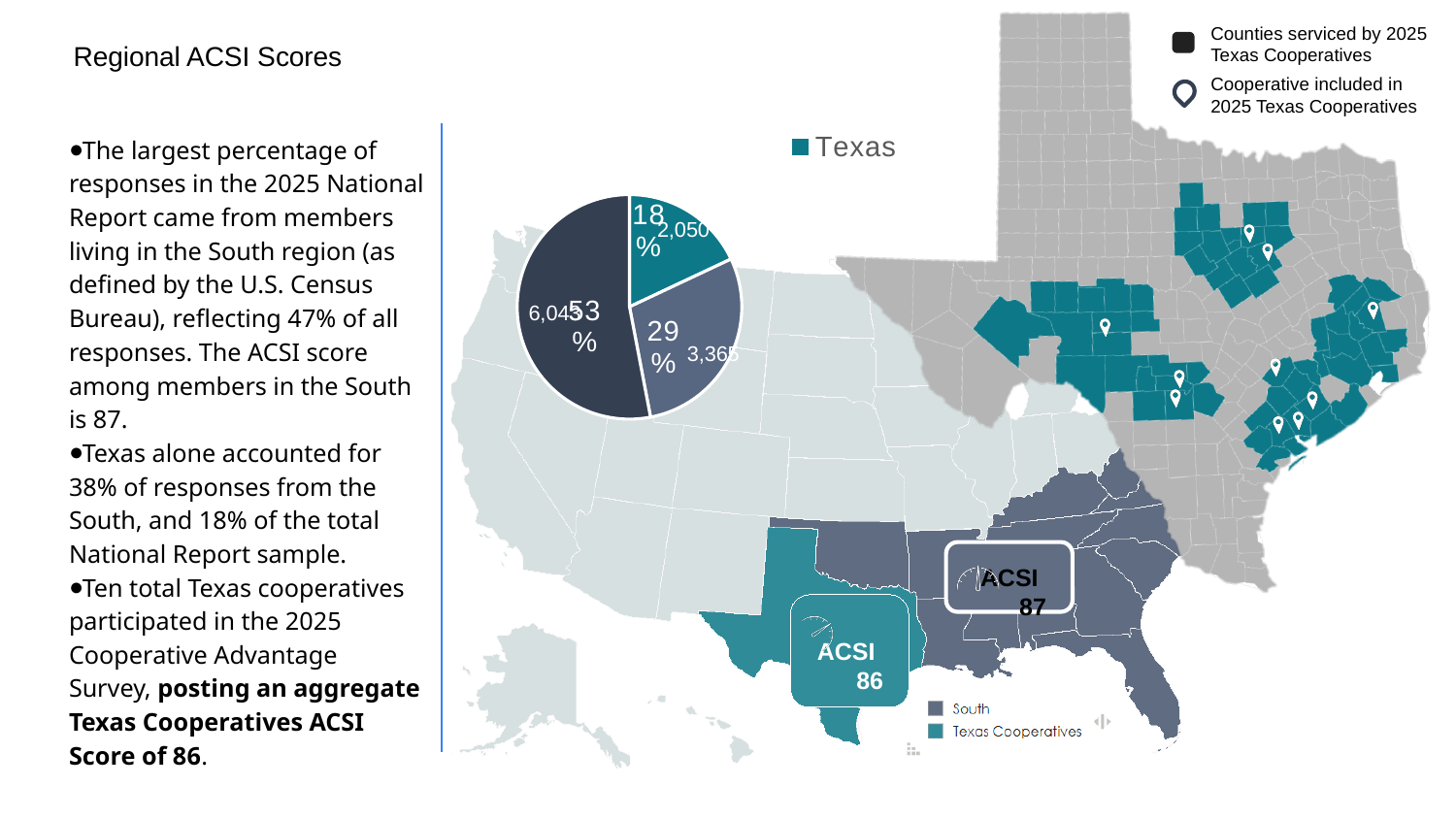
What is the largest percentage shown on any slice of the pie chart? 53% Which slice of the pie chart is the smallest? Texas In the pie chart, what is the difference in percentage points between the largest slice (53%) and the Texas slice (18%)? 35 percentage points What count is printed on the largest slice of the pie chart? 6,045 What kind of chart is shown in the middle of the slide, above the map? Pie chart In the pie chart, what count is printed on the Texas slice? 2,050 In the pie chart, which is larger: the Texas slice or the slice labeled 29%? The slice labeled 29% How many slices does the pie chart have? 3 What colour is the Texas slice in the pie chart? Teal In the pie chart, what percentage share does the Texas slice have? 18% How many entries does the pie chart's legend list? 1 What is the sum of the three counts printed on the pie chart slices (2,050, 3,365 and 6,045)? 11,460